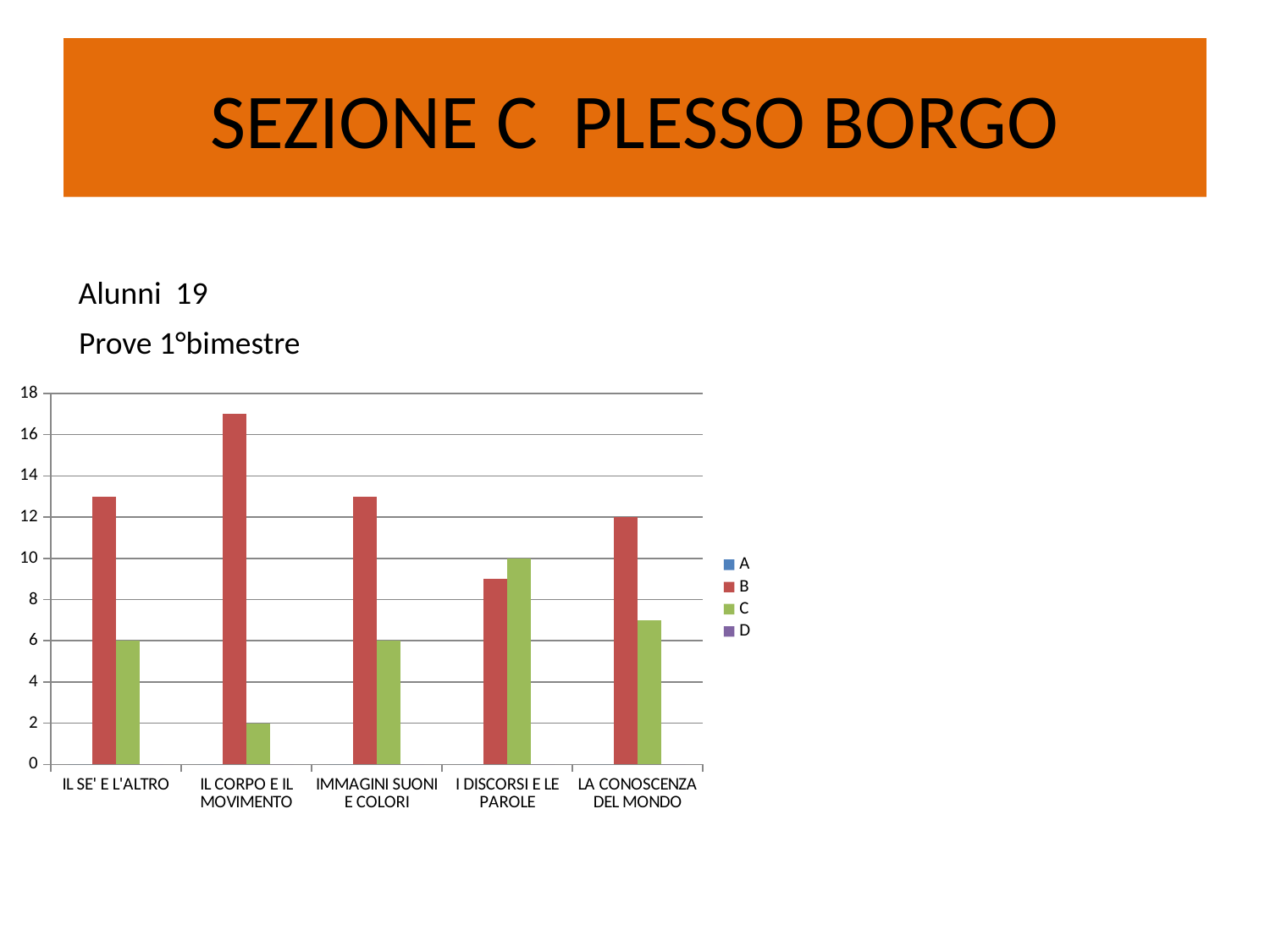
What is the value of series B for LA CONOSCENZA DEL MONDO? 12 What is the value of series C for IL CORPO E IL MOVIMENTO? 2 Is the value of series B for I DISCORSI E LE PAROLE greater or less than 10? less How many categories are shown on the x axis? 5 Is the value of series B for IL CORPO E IL MOVIMENTO greater or less than 16? greater What is the value of series C for IL SE' E L'ALTRO? 6 What is the difference between series C for I DISCORSI E LE PAROLE and series C for IL CORPO E IL MOVIMENTO? 8 How many series does the legend list? 4 For which category is series C lowest? IL CORPO E IL MOVIMENTO For I DISCORSI E LE PAROLE, which is larger, series B or series C? C For which category is series B highest? IL CORPO E IL MOVIMENTO What is the value of series C for I DISCORSI E LE PAROLE? 10